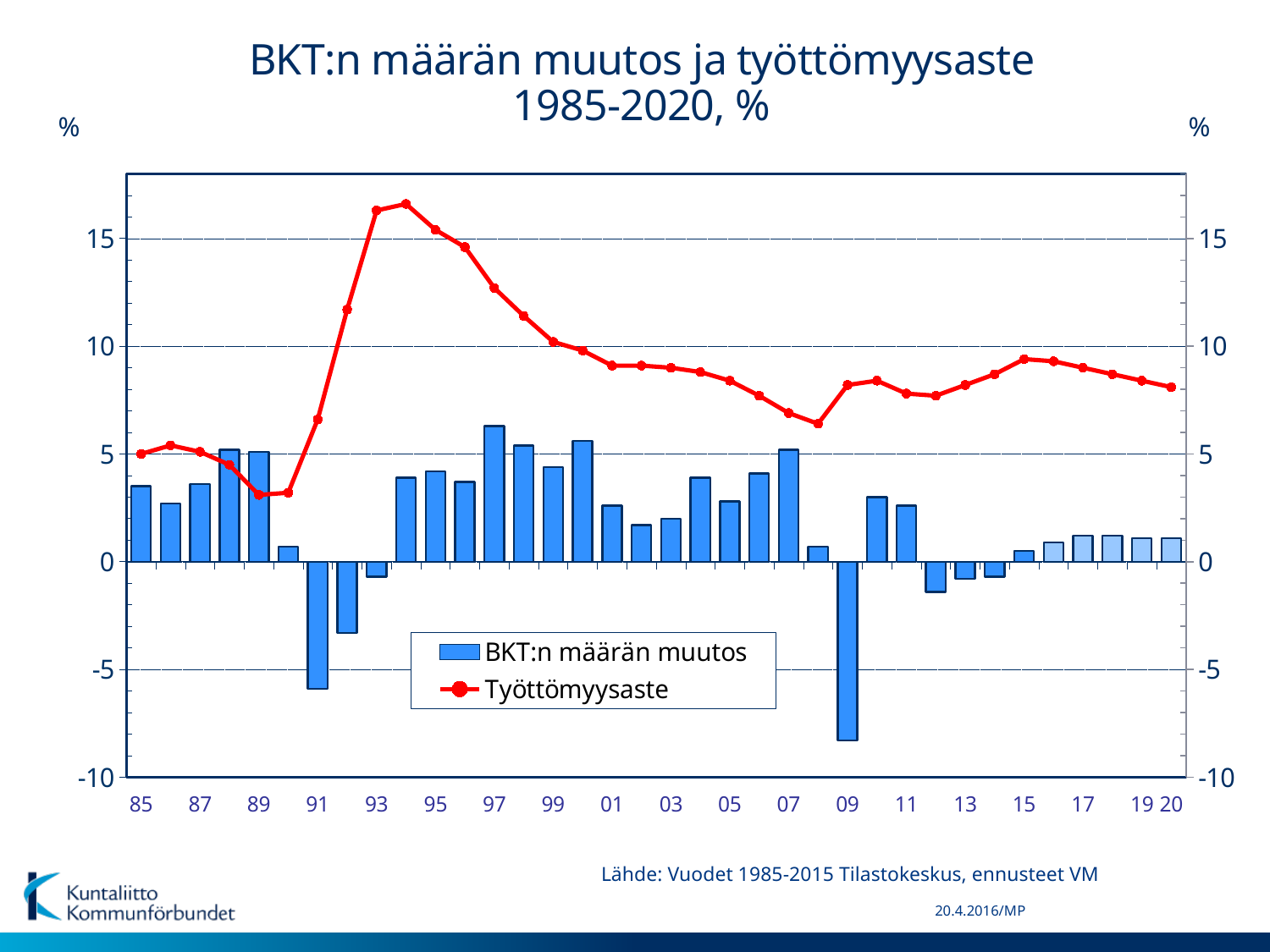
In which year is the BKT:n määrän muutos bar the highest? 1997 Which year has the lower BKT:n määrän muutos value, 1991 or 2009? 2009 Which series is drawn as a red line with markers? Työttömyysaste What are the two series named in the legend? BKT:n määrän muutos and Työttömyysaste What kind of chart is shown on the slide? A combination bar and line chart Is the Työttömyysaste value for 1994 greater or less than 15? greater In which year is the BKT:n määrän muutos bar the lowest? 2009 In which year does the Työttömyysaste line reach its highest point? 1994 Is the BKT:n määrän muutos value for 2009 greater or less than -5? less How many series does the legend list? 2 Does the Työttömyysaste line rise or fall between 1990 and 1994? It rises Is the Työttömyysaste value for 2001 greater or less than 10? less